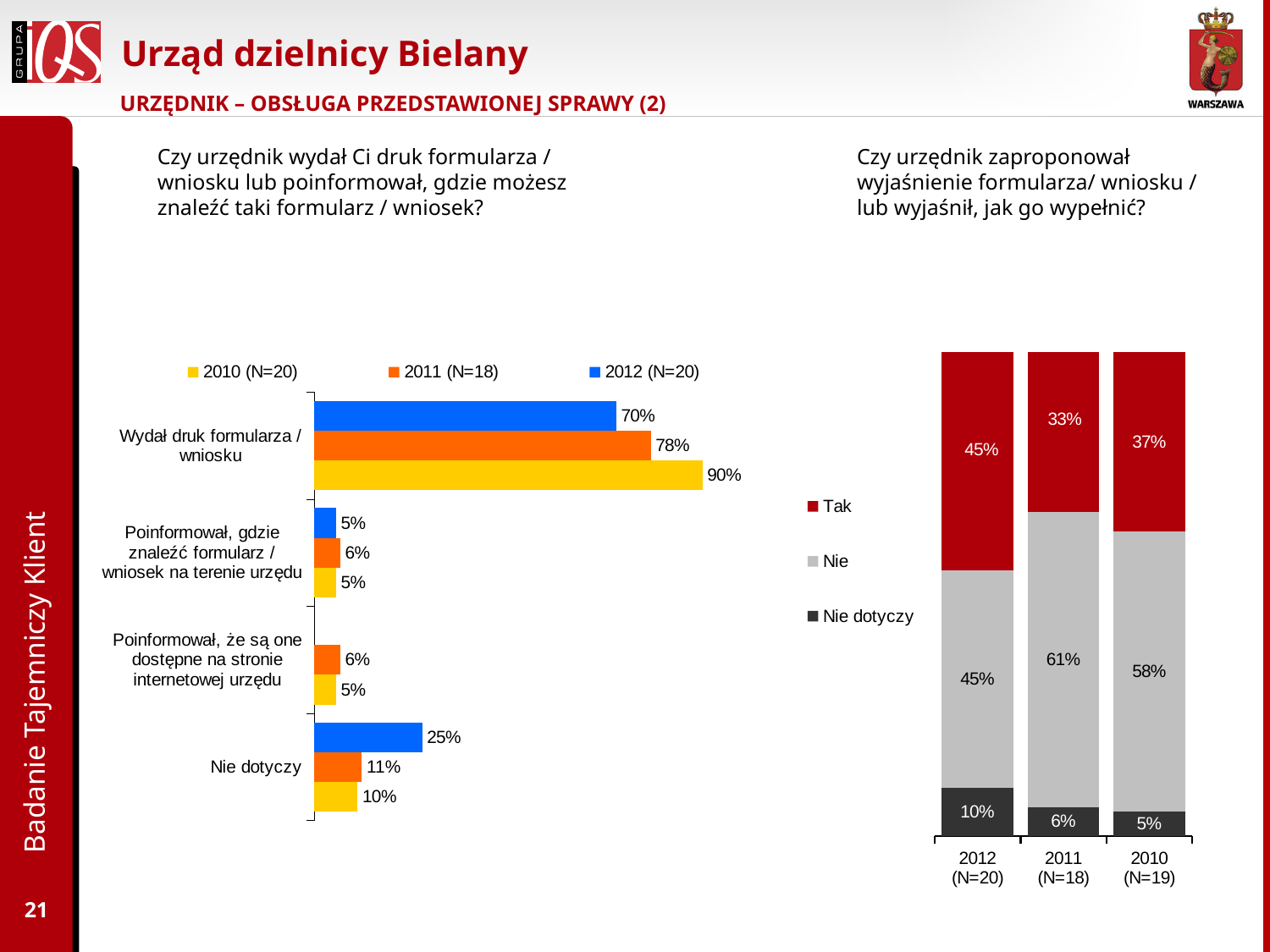
In the left chart, what is the value for 'Nie dotyczy' in the 2012 (N=20) series? 25% In the left chart, what is the value for 'Wydał druk formularza / wniosku' in the 2010 (N=20) series? 90% In the left chart, which is larger for 'Nie dotyczy': the 2011 value or the 2010 value? 2011 (N=18) In the left chart, what is the value for 'Poinformował, gdzie znaleźć formularz / wniosek na terenie urzędu' in the 2011 (N=18) series? 6% In the left chart, what is the difference between the 2010 and 2012 values for 'Wydał druk formularza / wniosku'? 20 percentage points In the right chart, what is the 'Tak' share for 2011 (N=18)? 33% In the right chart, which year has the highest 'Nie dotyczy' share? 2012 (N=20) In the left chart, which year has the highest value for 'Wydał druk formularza / wniosku'? 2010 (N=20) What kind of chart is the chart on the right? Stacked bar chart How many series does the legend of the left chart list? 3 In the right chart, what is the 'Nie' share for 2010 (N=19)? 58% In the right chart, what is the difference between the 'Nie' share for 2011 and the 'Nie' share for 2012? 16 percentage points